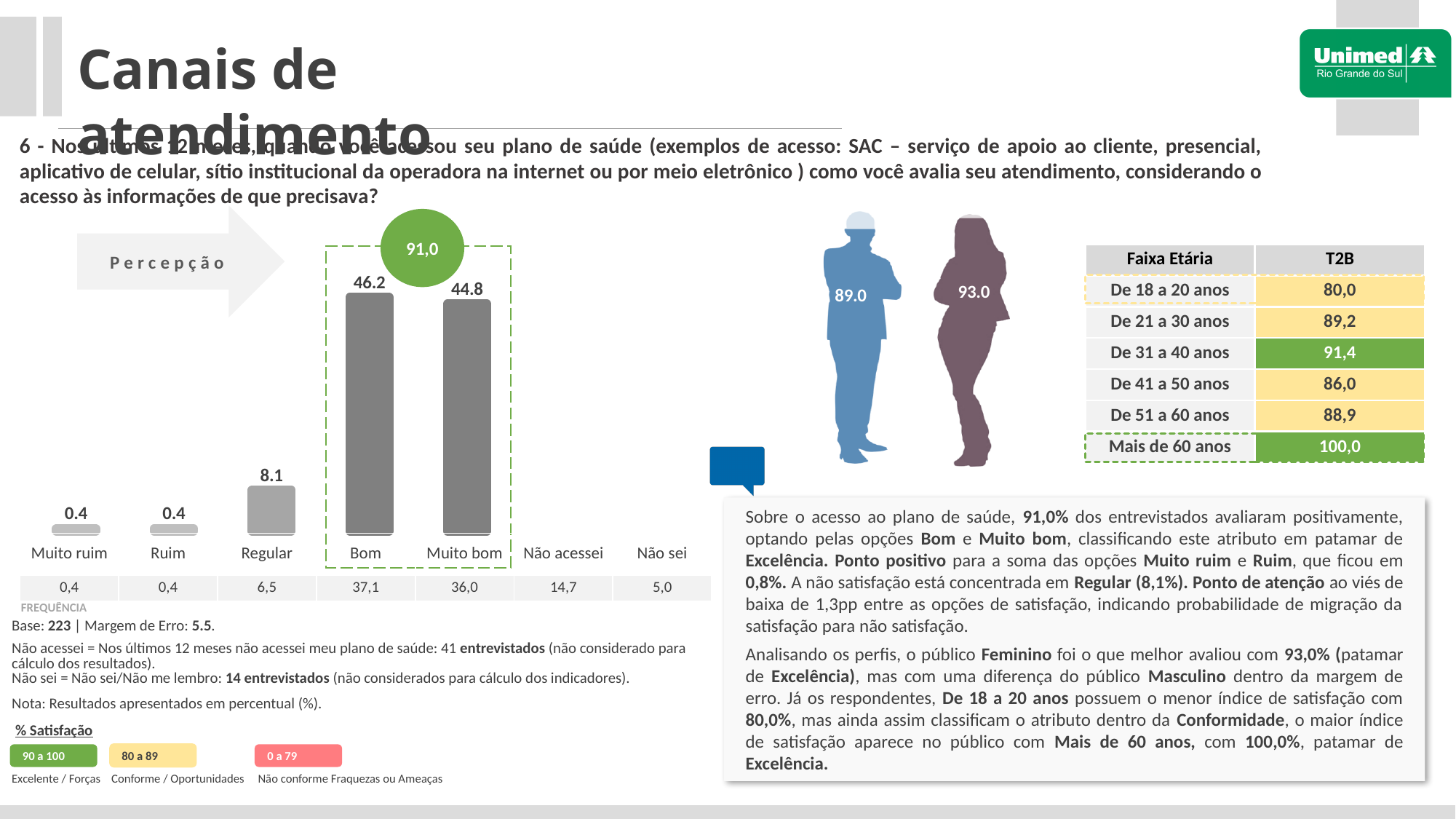
What is the value for Muito bom in the bar chart? 44.8 Which category has the highest value in the bar chart? Bom What is the difference between the values for Regular and Ruim in the bar chart? 7.7 What is the value for Regular in the bar chart? 8.1 How many bars with values are plotted in the bar chart? 5 What is the value for Bom in the bar chart? 46.2 Which two categories in the bar chart are enclosed by the dashed green box? Bom and Muito bom What is the combined value of Bom and Muito bom shown in the green circle above the bar chart? 91,0 What kind of chart is used to show the evaluation categories from Muito ruim to Muito bom? Bar chart What is the value for Muito ruim in the bar chart? 0.4 Which of Bom or Muito bom has the larger value in the bar chart? Bom What is the difference between the values for Bom and Muito bom in the bar chart? 1.4